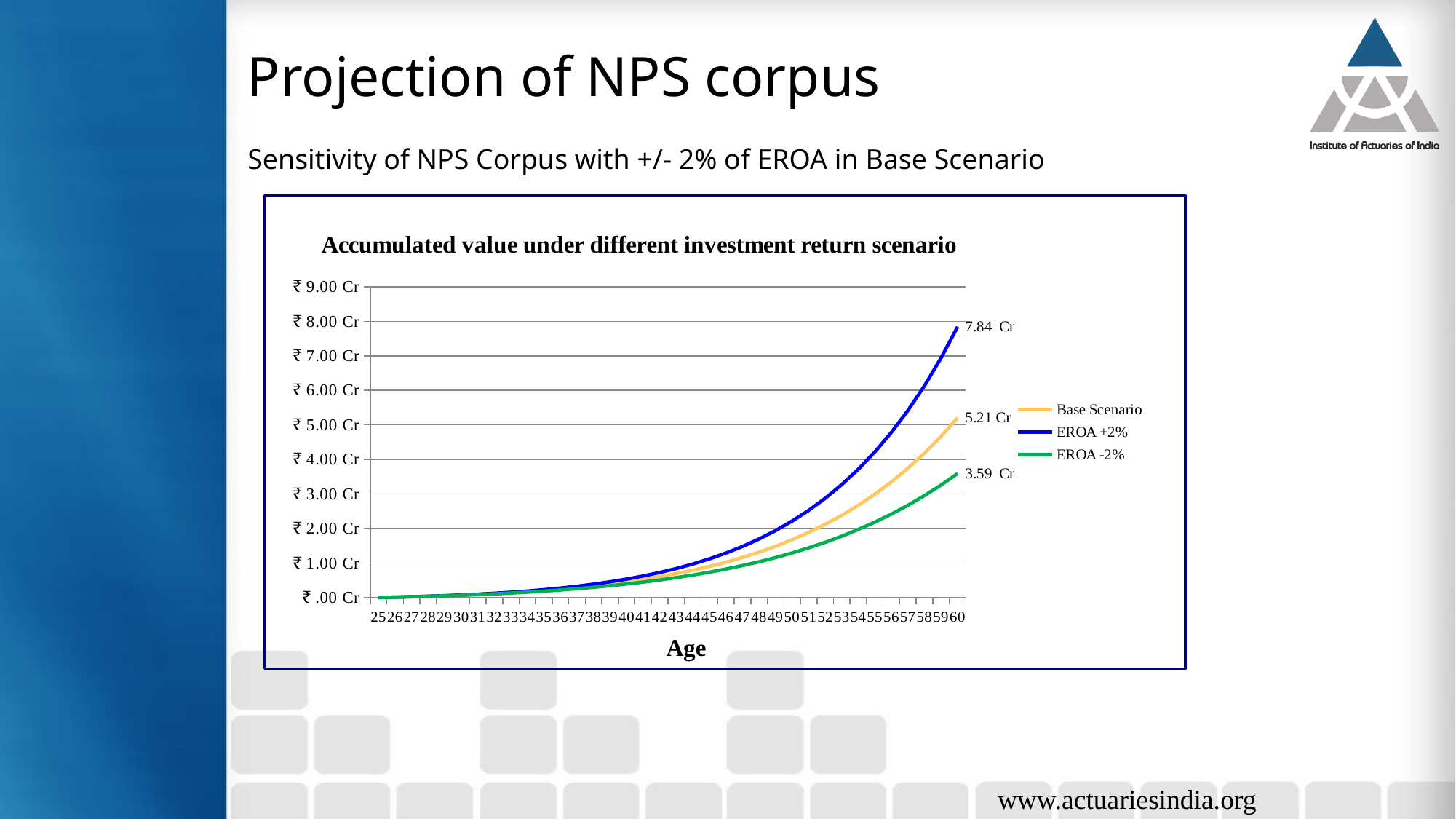
What is the labelled value of the EROA +2% series at age 60? 7.84 Cr What is the difference between the EROA +2% and EROA -2% values at age 60? 4.25 Cr What is the labelled value of the EROA -2% series at age 60? 3.59 Cr How many series does the legend list? 3 At age 60, which is larger: the Base Scenario value or the EROA -2% value? Base Scenario Which series has the highest accumulated value at age 60? EROA +2% Is the value of the EROA +2% series at age 50 greater or less than ₹ 4.00 Cr? less Which series has the lowest accumulated value at age 60? EROA -2% Do the accumulated values rise or fall as age increases along the x axis? rise What kind of chart is shown on the slide? line chart What is the labelled value of the Base Scenario series at age 60? 5.21 Cr What is the difference between the EROA +2% and Base Scenario values at age 60? 2.63 Cr